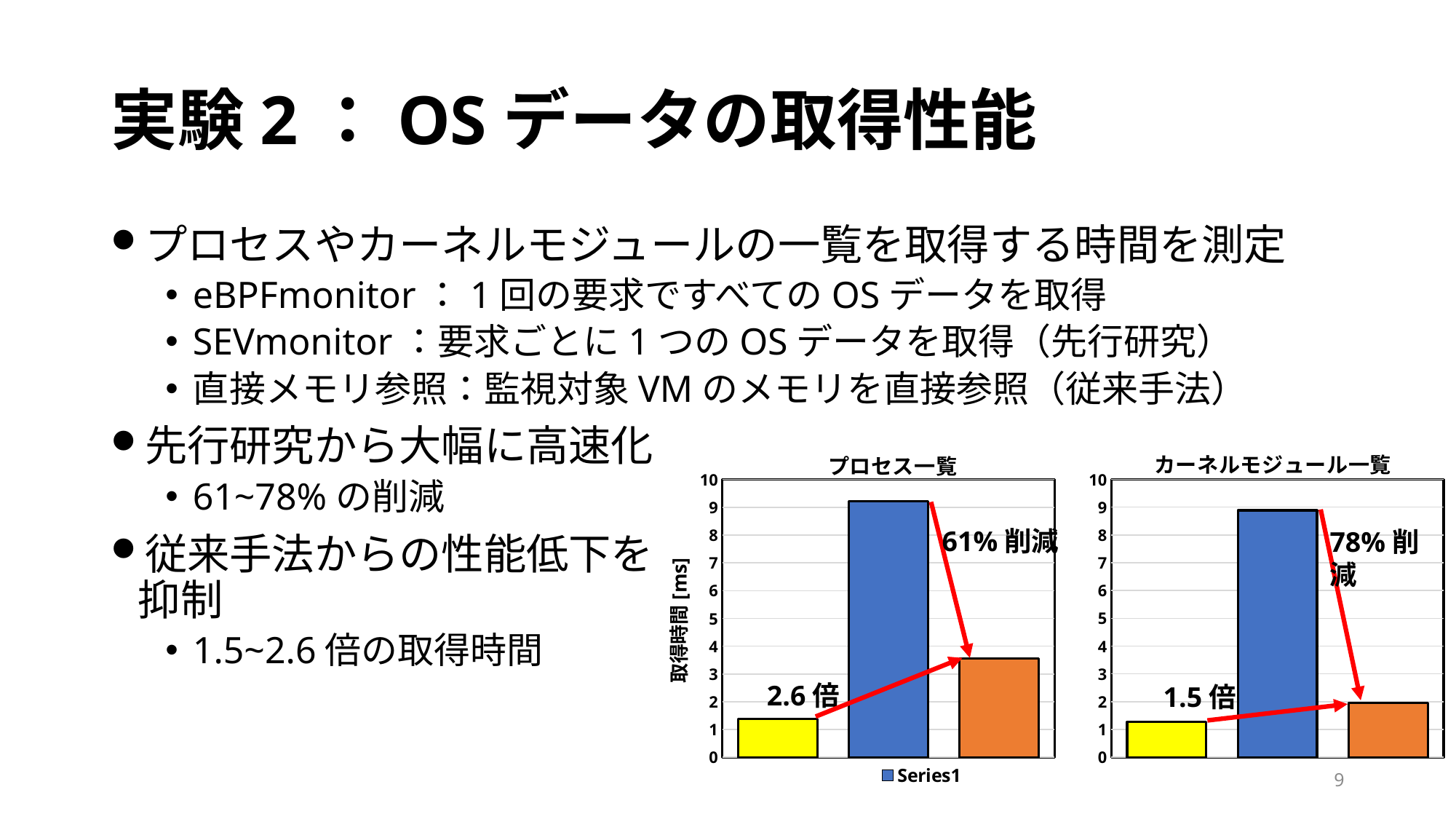
In the プロセス一覧 chart, is the value of the blue bar greater or less than 9? greater What percentage reduction is annotated on the カーネルモジュール一覧 chart? 78% 削減 How many series does the legend of the プロセス一覧 chart list? 1 What kind of chart is the プロセス一覧 chart? bar chart In the カーネルモジュール一覧 chart, which bar is the shortest: the yellow, blue or orange one? yellow In the カーネルモジュール一覧 chart, is the value of the blue bar greater or less than 8? greater In the カーネルモジュール一覧 chart, is the value of the orange bar greater or less than 3? less In the プロセス一覧 chart, which is larger, the orange bar or the yellow bar? orange bar In the プロセス一覧 chart, which bar is the tallest: the yellow, blue or orange one? blue How many bars are plotted in the カーネルモジュール一覧 chart? 3 What is the y-axis label of the プロセス一覧 chart? 取得時間 [ms]